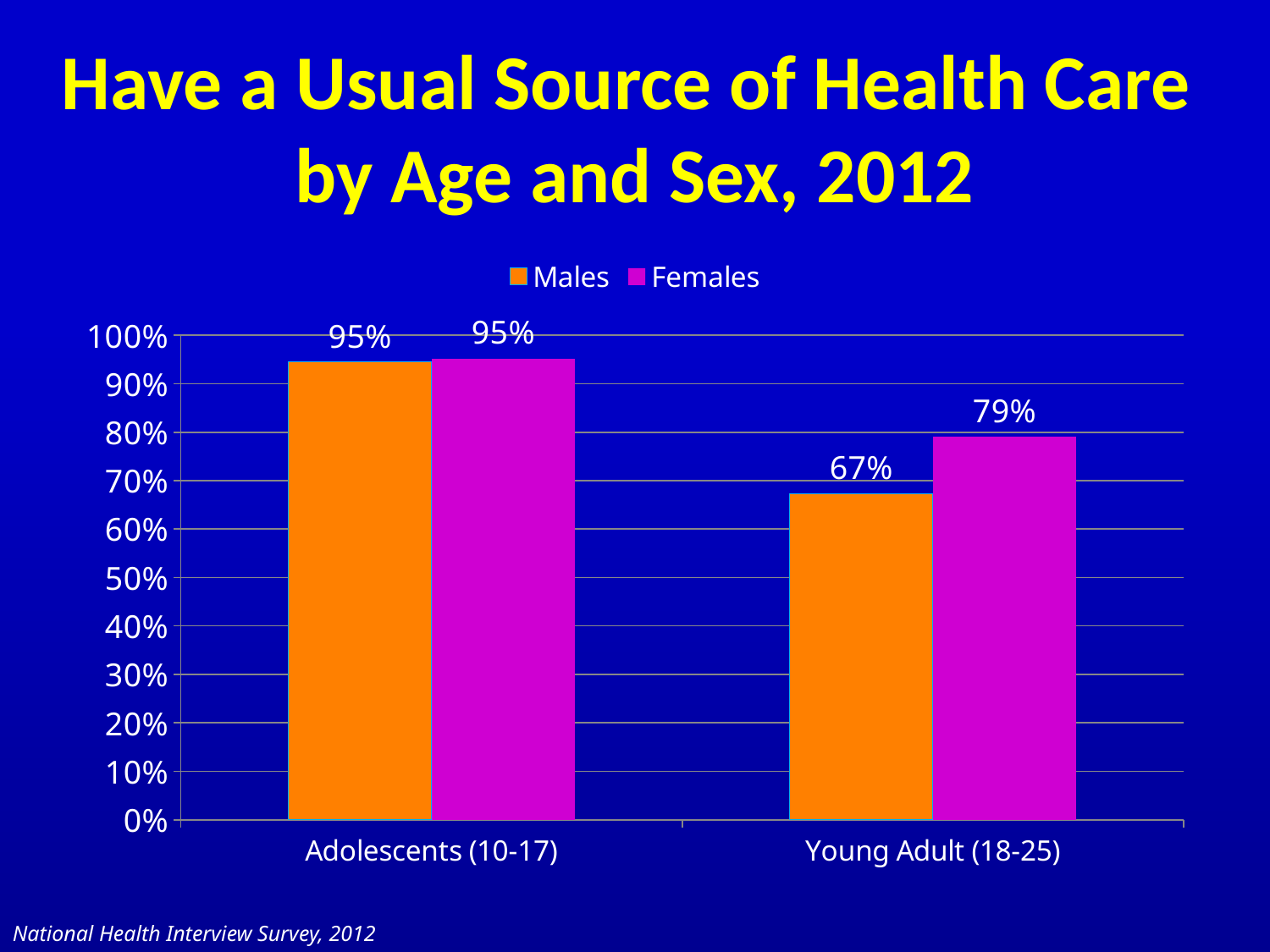
How many age categories are shown on the x axis? 2 What is the value for Females in the Adolescents (10-17) category? 95% For Young Adult (18-25), which is larger, the Males value or the Females value? Females What is the value for Males in the Young Adult (18-25) category? 67% What is the difference between the Males value for Adolescents (10-17) and the Males value for Young Adult (18-25)? 28 percentage points How many series does the legend list? 2 Is the value for Males in the Young Adult (18-25) category greater or less than 70%? less Which bar has the lowest value on the chart? Males, Young Adult (18-25) What percentage of male adolescents (10-17) have a usual source of health care? 95% What kind of chart is shown on the slide? Bar chart What percentage of female young adults (18-25) have a usual source of health care? 79% What is the difference between the Females and Males values for Young Adult (18-25)? 12 percentage points